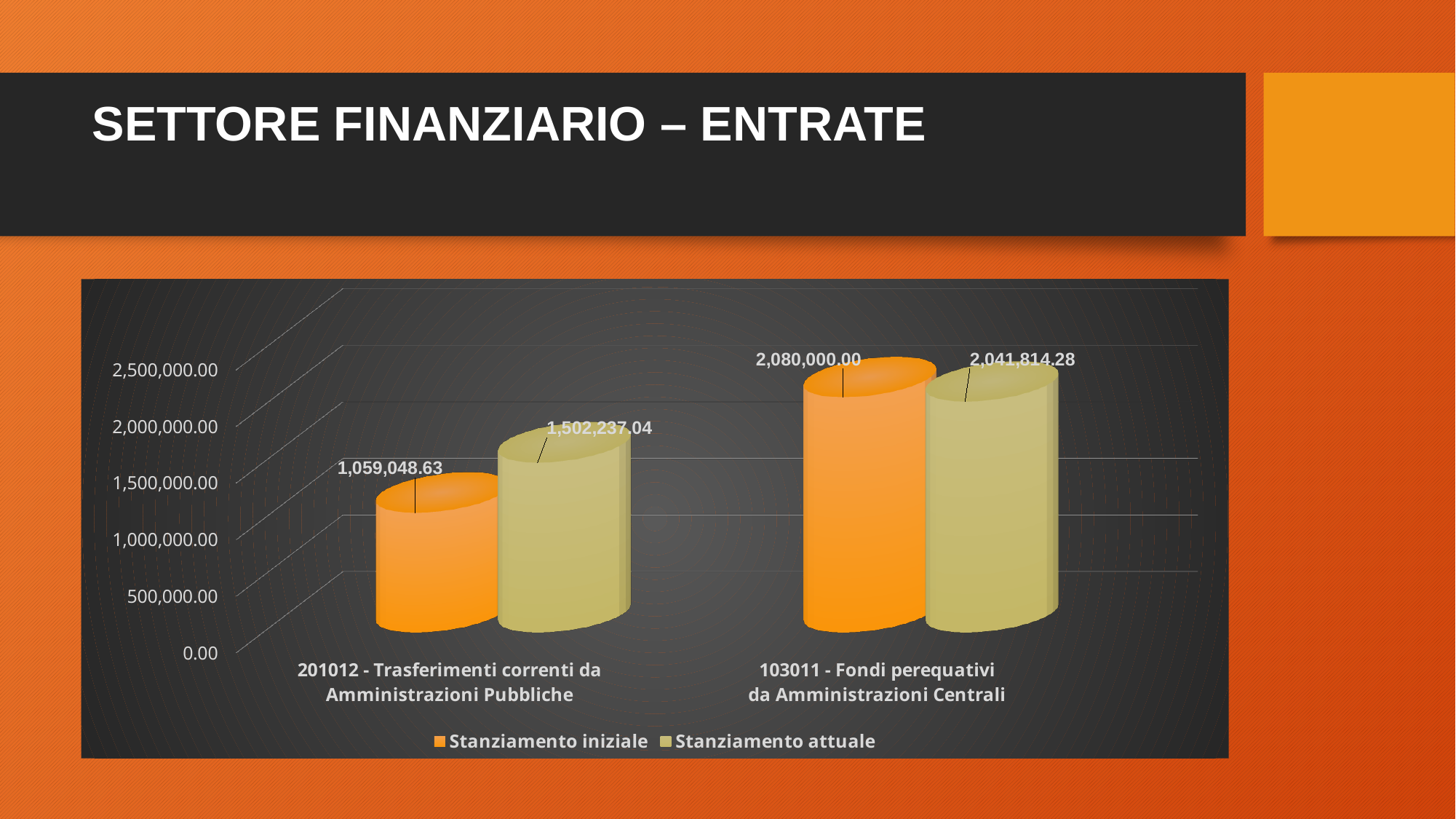
What is the difference between the Stanziamento iniziale and Stanziamento attuale values for 103011 - Fondi perequativi da Amministrazioni Centrali? 38,185.72 What is the Stanziamento iniziale value for 103011 - Fondi perequativi da Amministrazioni Centrali? 2,080,000.00 How many series does the chart legend list? 2 For 201012 - Trasferimenti correnti da Amministrazioni Pubbliche, which is larger: Stanziamento iniziale or Stanziamento attuale? Stanziamento attuale Which category has the highest Stanziamento iniziale value? 103011 - Fondi perequativi da Amministrazioni Centrali What is the Stanziamento iniziale value for 201012 - Trasferimenti correnti da Amministrazioni Pubbliche? 1,059,048.63 What is the difference between the Stanziamento attuale and Stanziamento iniziale values for 201012 - Trasferimenti correnti da Amministrazioni Pubbliche? 443,188.41 How many categories are shown on the x axis of the chart? 2 What is the Stanziamento attuale value for 201012 - Trasferimenti correnti da Amministrazioni Pubbliche? 1,502,237.04 What is the Stanziamento attuale value for 103011 - Fondi perequativi da Amministrazioni Centrali? 2,041,814.28 What kind of chart is shown on the slide? Bar chart Which category has the lowest Stanziamento attuale value? 201012 - Trasferimenti correnti da Amministrazioni Pubbliche